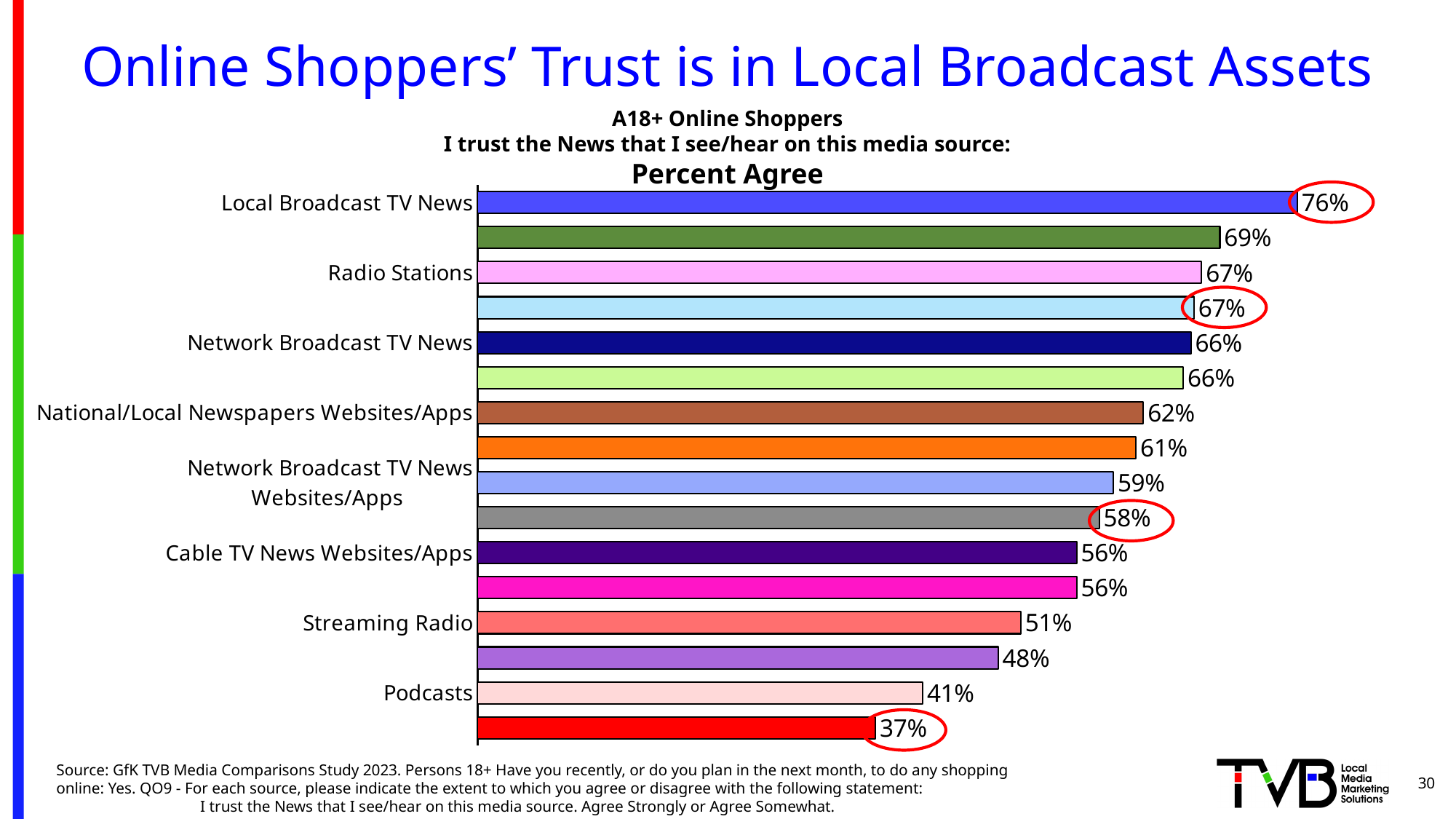
What is the Percent Agree value for Network Broadcast TV News? 66% Which media source has the highest Percent Agree on the chart? Local Broadcast TV News What is the difference in Percent Agree between Local Broadcast TV News and Network Broadcast TV News? 10 percentage points Which has a higher Percent Agree: National/Local Newspapers Websites/Apps or Cable TV News Websites/Apps? National/Local Newspapers Websites/Apps What is the Percent Agree value for Radio Stations? 67% What is the difference in Percent Agree between Network Broadcast TV News Websites/Apps and Podcasts? 18 percentage points What type of chart is shown on the slide? Bar chart What is the Percent Agree value for Podcasts? 41% What is the lowest Percent Agree value shown on the chart? 37% What percent of A18+ online shoppers agree they trust the news on Local Broadcast TV News? 76% What is the Percent Agree value for Streaming Radio? 51% How many bars are plotted on the chart? 16